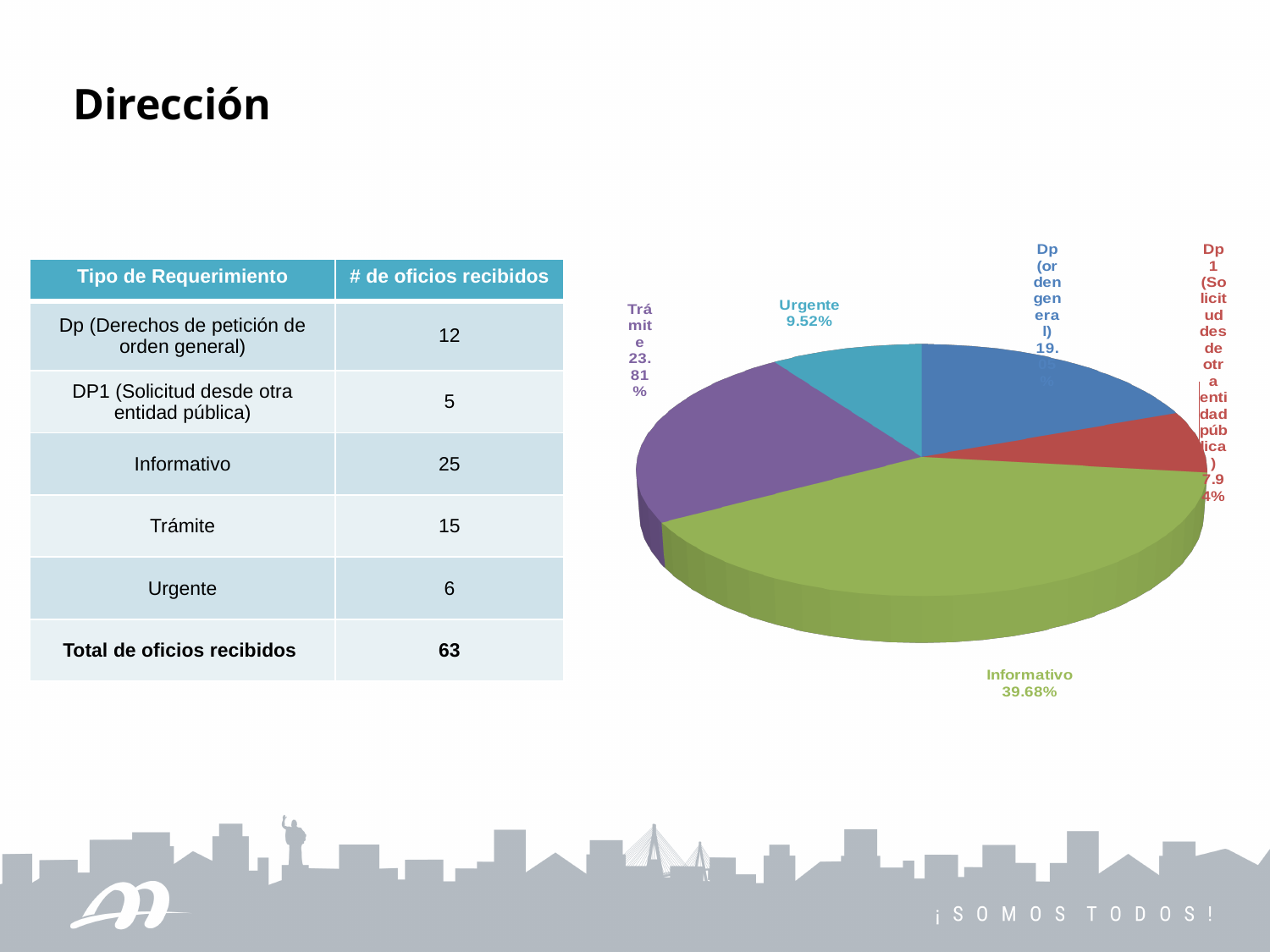
Which category has the smallest slice of the pie? Dp1 (Solicitud desde otra entidad pública) What colour is the Informativo slice of the pie? green What share of the pie does Informativo represent? 39.68% What kind of chart is shown on the slide? pie chart Is the share for Dp (orden general) greater or less than 25%? less What share of the pie does Urgente represent? 9.52% Which slice is larger, Trámite or Urgente? Trámite Which category has the largest slice of the pie? Informativo How many slices does the pie chart have? 5 What share of the pie does Trámite represent? 23.81% What colour is the Trámite slice of the pie? purple What is the difference in percentage points between the Informativo and Trámite slices? 15.87